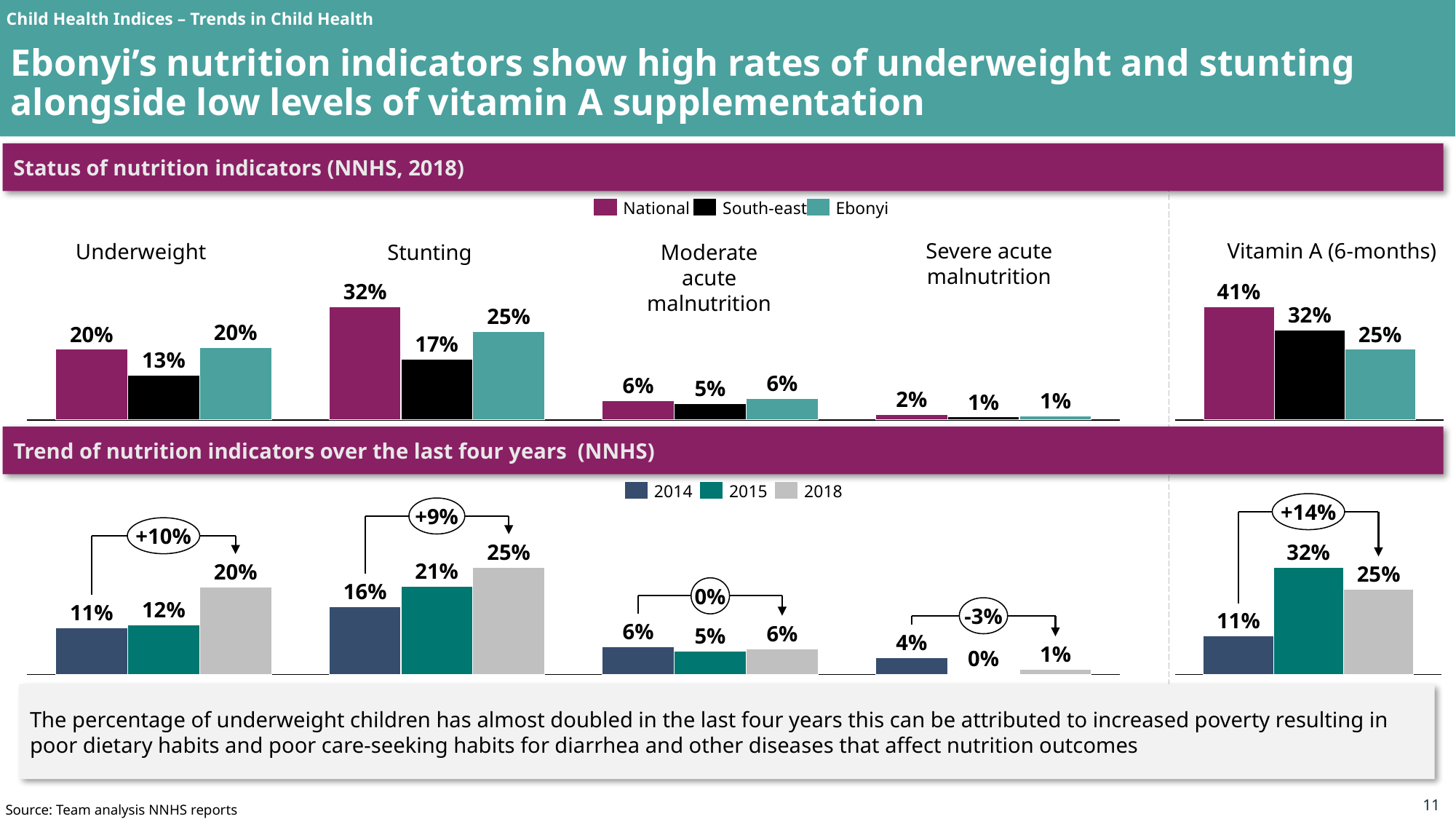
In the 'Status of nutrition indicators (NNHS, 2018)' chart, what is the National value for Stunting? 32% What kind of chart is used in the 'Status of nutrition indicators (NNHS, 2018)' section? bar chart In the 'Status of nutrition indicators (NNHS, 2018)' chart, what is the South-east value for Underweight? 13% In the 'Status of nutrition indicators (NNHS, 2018)' chart, what is the Ebonyi value for Vitamin A (6-months)? 25% In the 'Trend of nutrition indicators over the last four years (NNHS)' chart, do the Underweight values rise or fall from 2014 to 2018? rise In the 'Status of nutrition indicators (NNHS, 2018)' chart, what is the difference between the National and South-east values for Stunting? 15% In the 'Trend of nutrition indicators over the last four years (NNHS)' chart, what is the 2014 value for Underweight? 11% In the 'Trend of nutrition indicators over the last four years (NNHS)' chart, what is the 2015 value for Vitamin A (6-months)? 32% In the 'Status of nutrition indicators (NNHS, 2018)' chart, which series has the highest value for Vitamin A (6-months)? National In the 'Trend of nutrition indicators over the last four years (NNHS)' chart, is the 2018 value for Stunting larger or smaller than the 2014 value? larger In the 'Status of nutrition indicators (NNHS, 2018)' chart, how many series does the legend list? 3 In the 'Trend of nutrition indicators over the last four years (NNHS)' chart, which year has the lowest value for Severe acute malnutrition? 2015